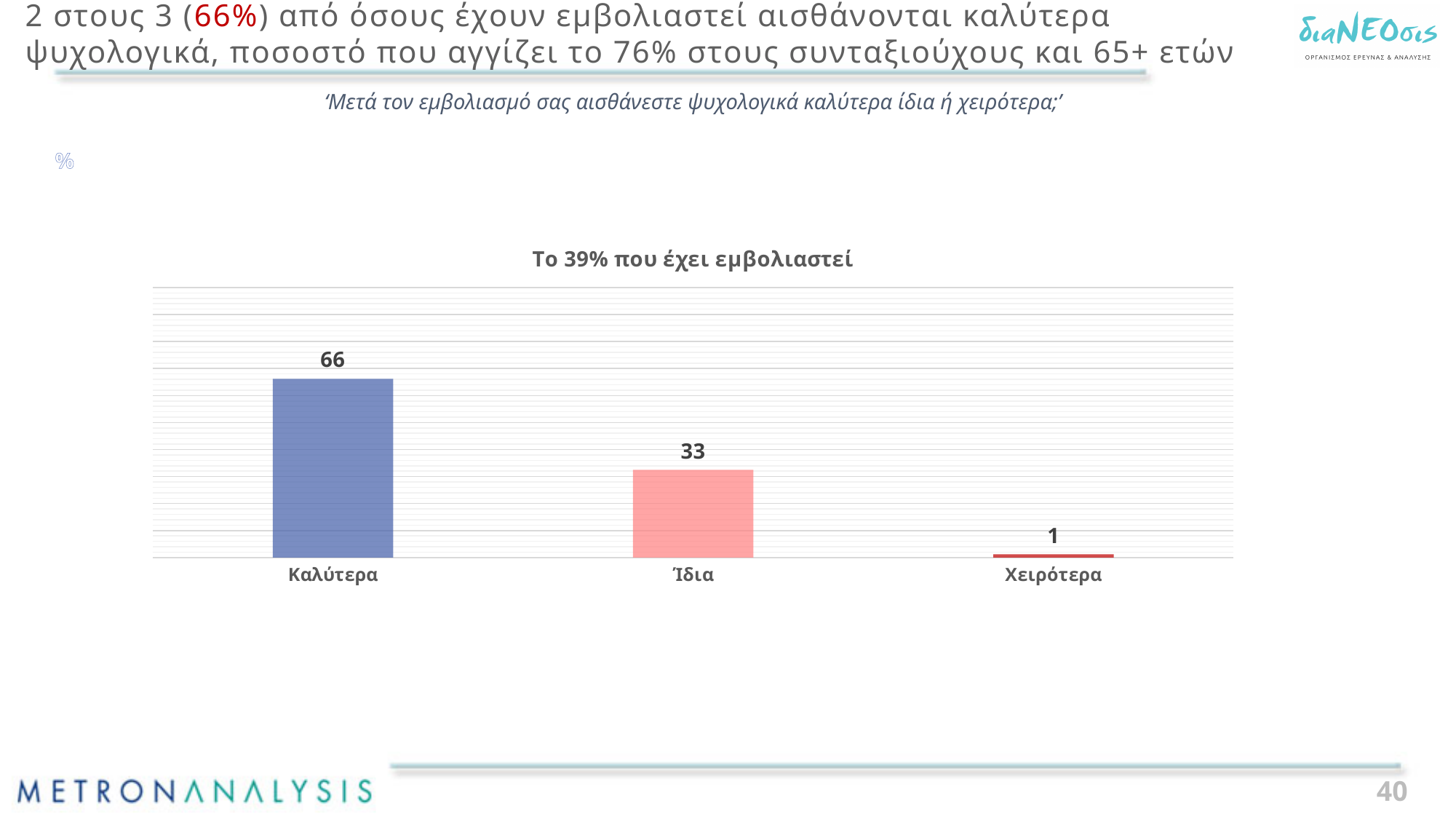
Which category has the lowest value? Χειρότερα What is the difference between the values for Καλύτερα and Ίδια? 33 Which category has the highest value? Καλύτερα What is the difference between the values for Ίδια and Χειρότερα? 32 What is the value for Καλύτερα? 66 What is the value for Χειρότερα? 1 How many categories are shown in the chart? 3 What is the value for Ίδια? 33 What is the title of the chart? Το 39% που έχει εμβολιαστεί What kind of chart is shown on the slide? Bar chart Which is larger, the value for Ίδια or the value for Χειρότερα? Ίδια Do the values rise or fall from left to right across the categories? Fall